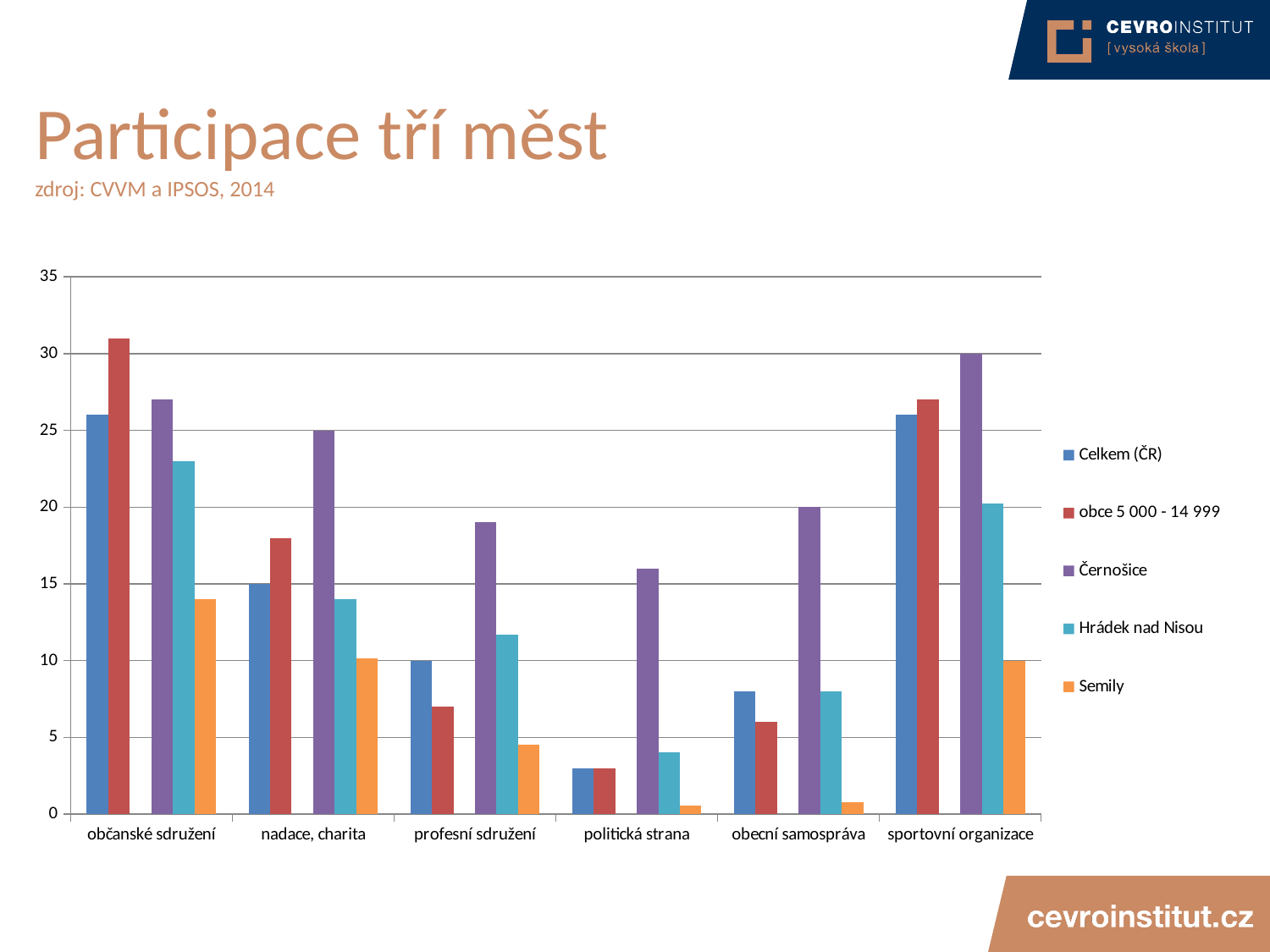
Which category has the lowest value for Semily? politická strana Is the value for Celkem (ČR) in občanské sdružení greater or less than 25? greater Is the value for Celkem (ČR) in politická strana greater or less than 5? less Is the value for obce 5 000 - 14 999 in občanské sdružení greater or less than 30? greater How many categories are shown on the x axis? 6 What is the title of the slide containing the chart? Participace tří měst In politická strana, which is larger: Černošice or Hrádek nad Nisou? Černošice What kind of chart is shown on the slide? bar chart Which series has the highest value in obecní samospráva? Černošice Which category has the highest value for Černošice? sportovní organizace How many series does the legend list? 5